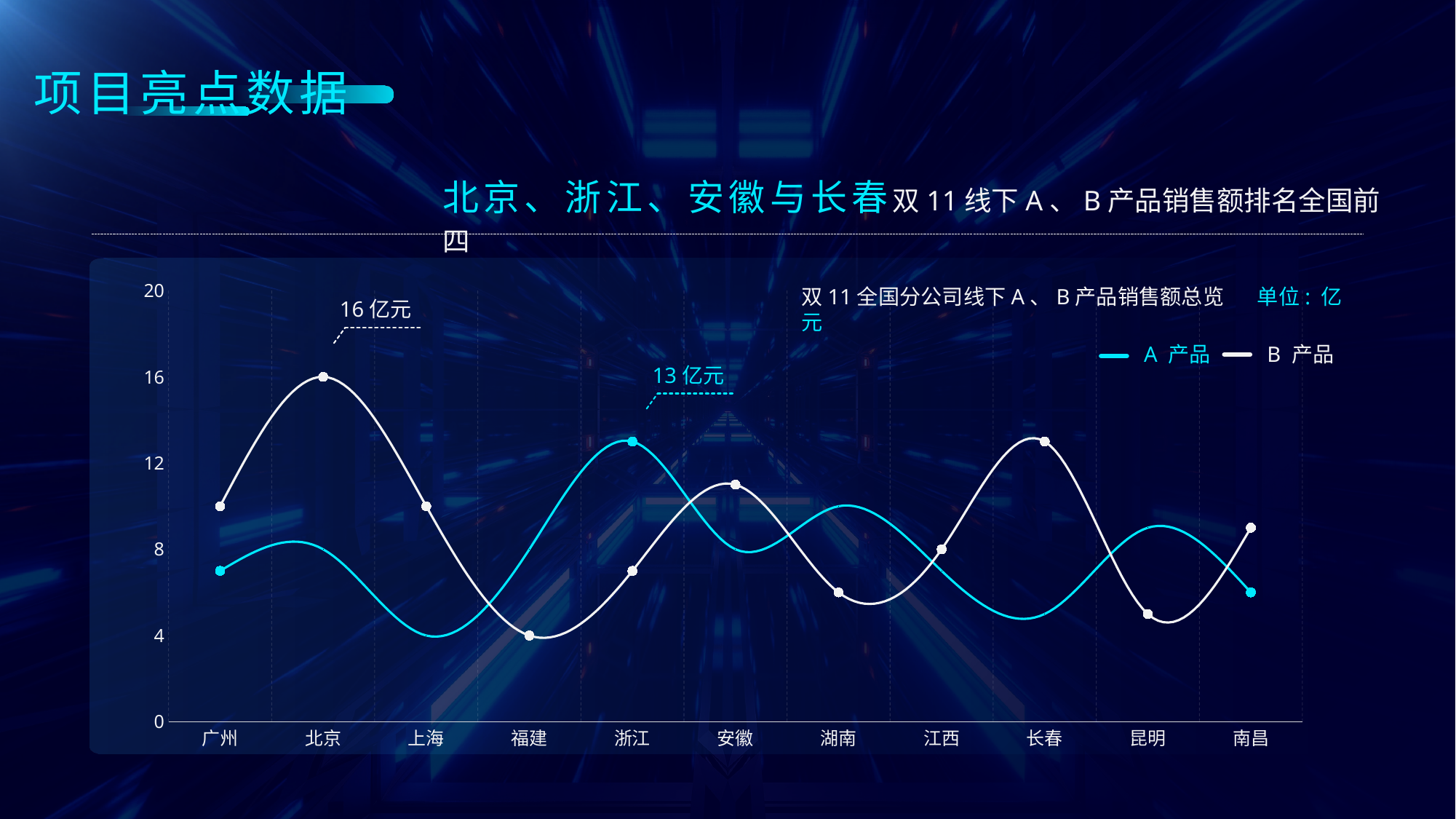
At 浙江, which series has the larger value, A 产品 or B 产品? A 产品 Is the value for B 产品 at 福建 greater or less than 8? less How many series does the chart legend list? 2 Which city has the highest value for B 产品? 北京 What is the difference between the B 产品 value at 北京 and the A 产品 value at 浙江? 3 亿元 What unit is stated for the values in the chart? 亿元 What kind of chart is shown on the slide? line chart How many cities are shown along the x axis of the chart? 11 At 北京, which series has the larger value, A 产品 or B 产品? B 产品 What is the value for A 产品 at 浙江? 13 亿元 Which city has the highest value for A 产品? 浙江 What is the value for B 产品 at 北京? 16 亿元